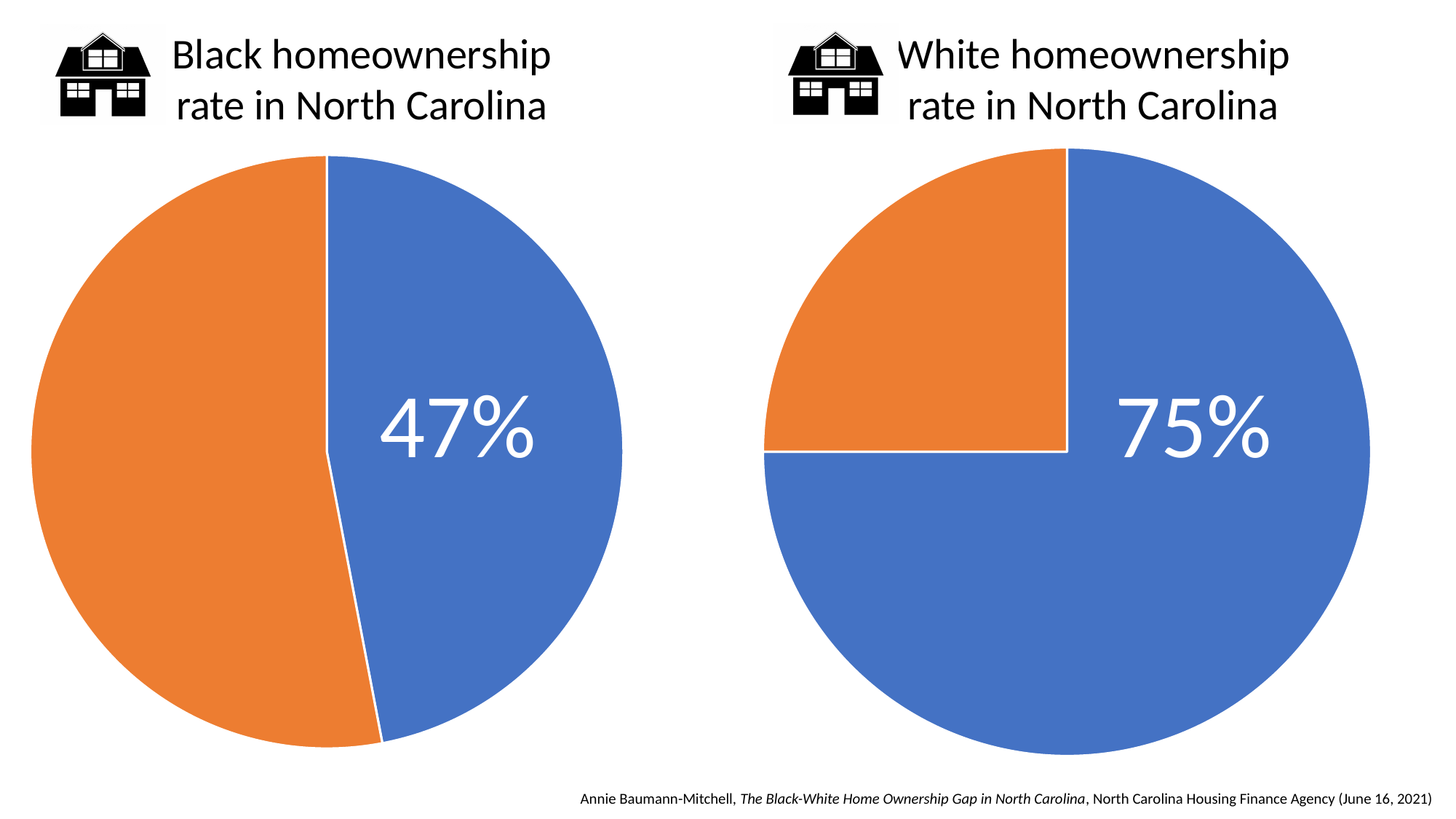
What kind of chart is the 'Black homeownership rate in North Carolina' chart? pie chart In the 'White homeownership rate in North Carolina' chart, is the blue slice greater or less than 50% of the pie? greater How many slices does the 'Black homeownership rate in North Carolina' pie chart have? 2 In the 'Black homeownership rate in North Carolina' chart, what value is printed on the blue slice? 47% How many slices does the 'White homeownership rate in North Carolina' pie chart have? 2 Which chart shows the larger labelled blue slice, the Black homeownership chart or the White homeownership chart? White homeownership rate in North Carolina What kind of chart is the 'White homeownership rate in North Carolina' chart? pie chart What is the difference between the labelled value in the White homeownership chart and the labelled value in the Black homeownership chart? 28% What is the title of the pie chart on the left side of the slide? Black homeownership rate in North Carolina In the 'Black homeownership rate in North Carolina' chart, is the blue slice greater or less than 50% of the pie? less What colour is the slice labelled 75% in the 'White homeownership rate in North Carolina' chart? blue In the 'White homeownership rate in North Carolina' chart, what value is printed on the blue slice? 75%